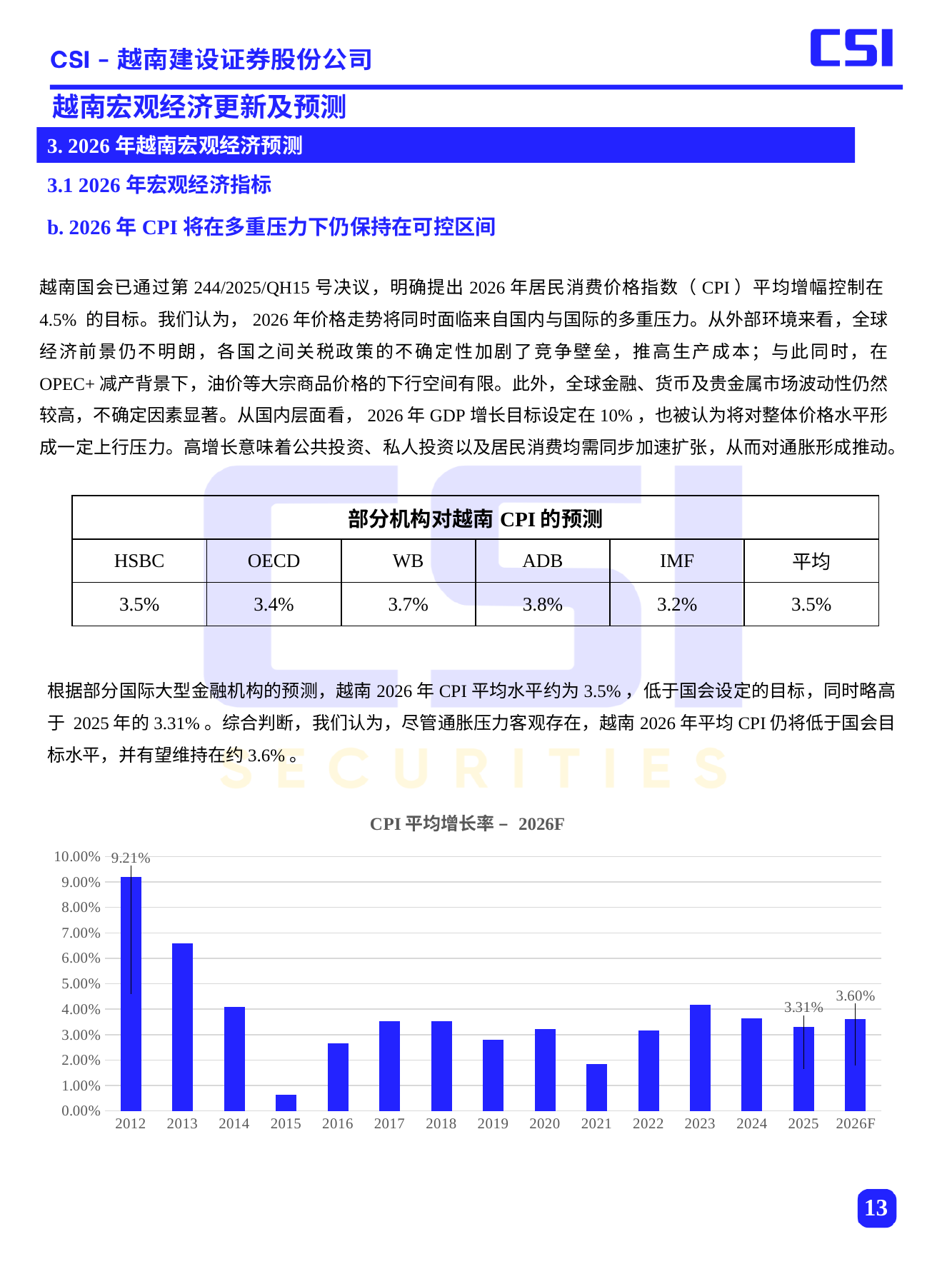
Which year has the higher CPI growth rate, 2013 or 2014? 2013 Which year has the higher CPI growth rate, 2022 or 2023? 2023 By how many percentage points does the 2026F value exceed the 2025 value? 0.29% Which year has the lowest CPI growth rate in the chart? 2015 What is the forecast CPI growth rate shown for 2026F? 3.60% Which year has the highest CPI growth rate in the chart? 2012 Is the value for 2015 greater or less than 1.00%? less Is the value for 2013 greater or less than 6.00%? greater What is the CPI average growth rate shown for 2012? 9.21% What value is labelled for 2025 in the chart? 3.31% What type of chart is used to show the CPI average growth rate? Bar chart How many years (bars) are shown in the chart? 15